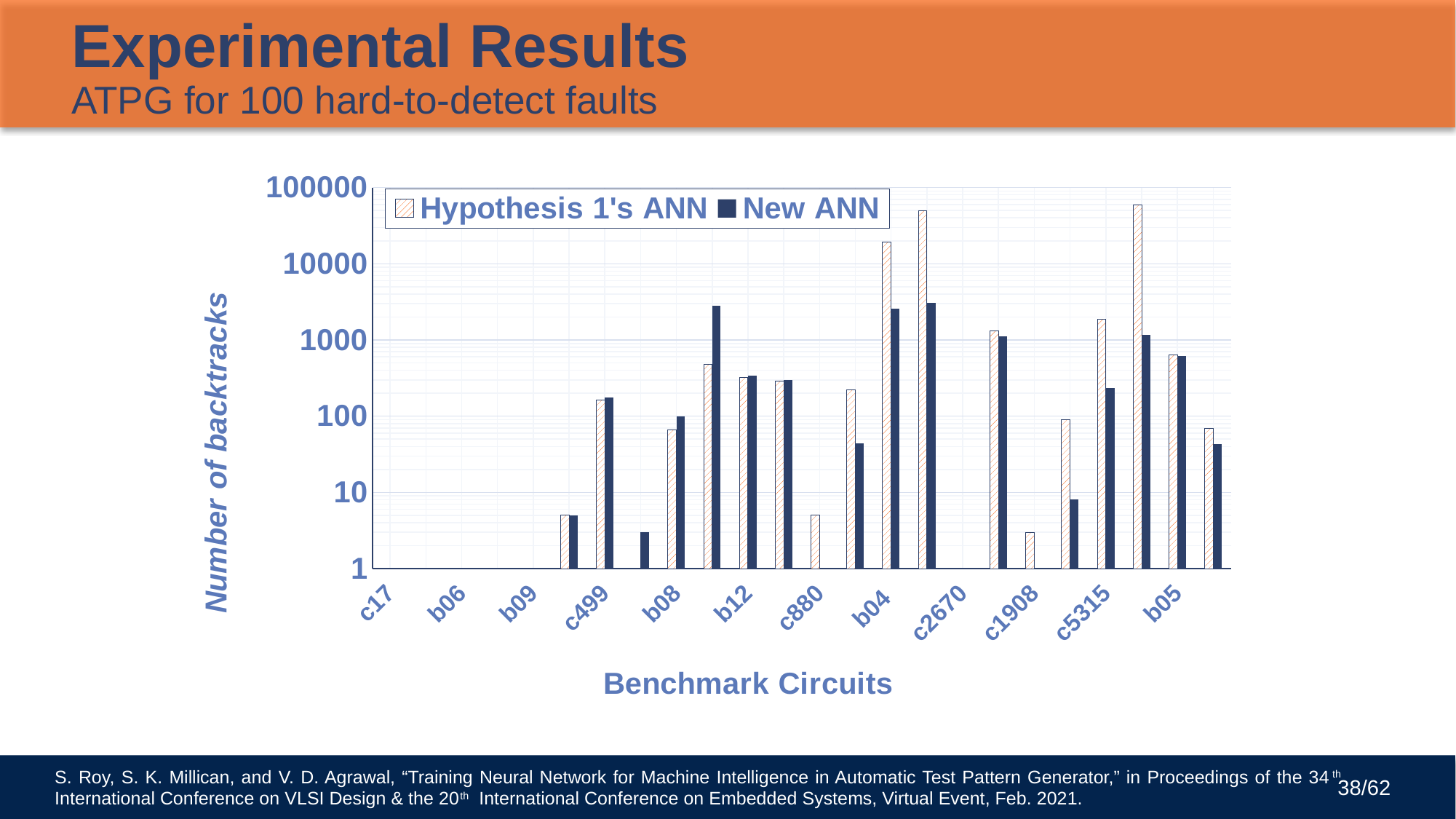
Which series contains the tallest bar on the chart? Hypothesis 1's ANN What is the title of the vertical axis? Number of backtracks What is the highest value printed on the vertical axis? 100000 What kind of chart is shown on the slide? bar chart Is the tallest bar on the chart greater or less than 10000 backtracks? greater What are the two series named in the legend? Hypothesis 1's ANN and New ANN How many series does the legend list? 2 How many benchmark circuit labels are printed along the x axis? 12 What is the lowest value printed on the vertical axis? 1